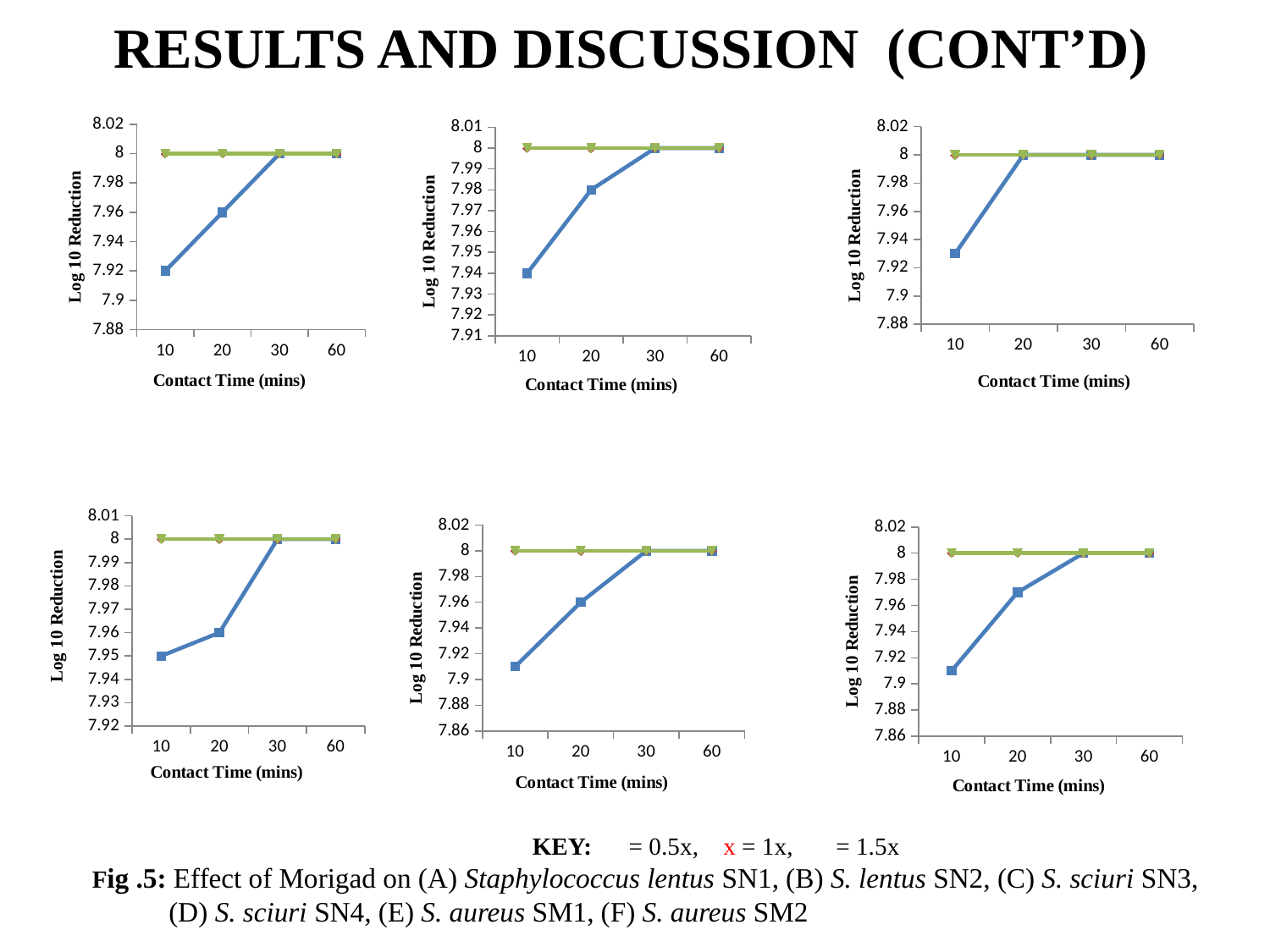
In the bottom-middle chart (E), is the blue line's value at 10 mins greater or less than 7.92? less In the top-left chart (A), does the blue line rise or fall as contact time increases from 10 to 30 mins? rise In the top-left chart (A), what is the Log 10 Reduction of the blue line at 20 mins? 7.96 In the top-right chart (C), is the blue line's value at 10 mins greater or less than 7.94? less In the top-left chart (A), what is the Log 10 Reduction of the blue line at 10 mins? 7.92 What kind of chart is the top-left chart (A)? line chart In the bottom-left chart (D), what is the Log 10 Reduction of the blue line at 10 mins? 7.95 What is the x-axis title of the bottom-right chart (F)? Contact Time (mins) In the top-middle chart (B), what is the Log 10 Reduction of the blue line at 20 mins? 7.98 In the top-left chart (A), what is the difference between the blue line's values at 20 mins and 10 mins? 0.04 How many contact time points are plotted on the x axis of the top-left chart (A)? 4 In the top-middle chart (B), what is the Log 10 Reduction of the blue line at 10 mins? 7.94